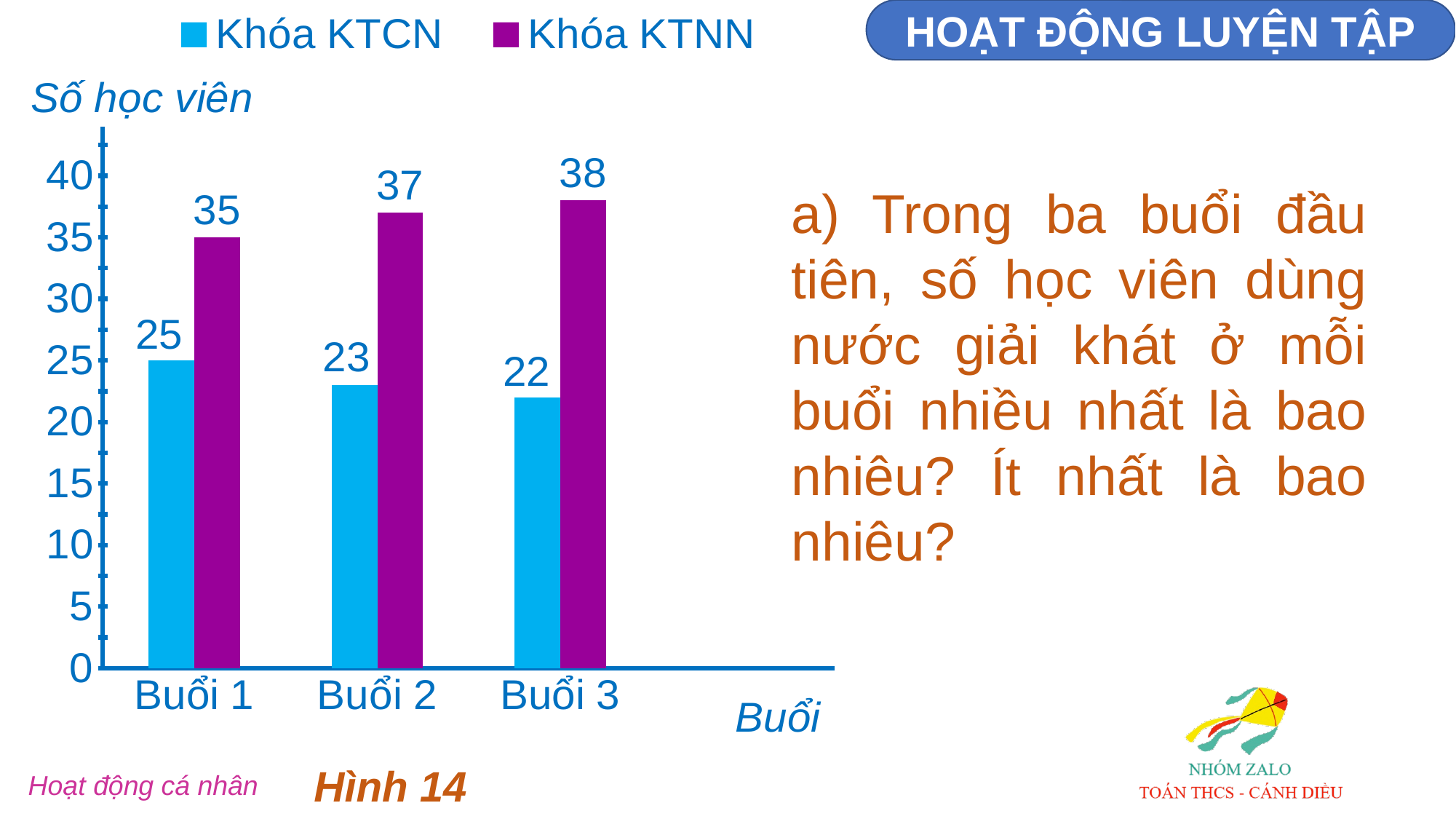
How many series does the legend list? 2 What is the difference between Khóa KTNN and Khóa KTCN in Buổi 1? 10 Which session (Buổi) has the highest value for Khóa KTNN? Buổi 3 What is the value for Khóa KTCN in Buổi 1? 25 How many sessions (Buổi) are shown on the x axis? 3 What is the label of the vertical axis? Số học viên Is the value for Khóa KTNN in Buổi 3 greater or less than 30? greater What is the value for Khóa KTNN in Buổi 2? 37 Which session (Buổi) has the lowest value for Khóa KTCN? Buổi 3 What kind of chart is shown on the slide? bar chart Which is larger in Buổi 2: Khóa KTCN or Khóa KTNN? Khóa KTNN What is the value for Khóa KTCN in Buổi 3? 22